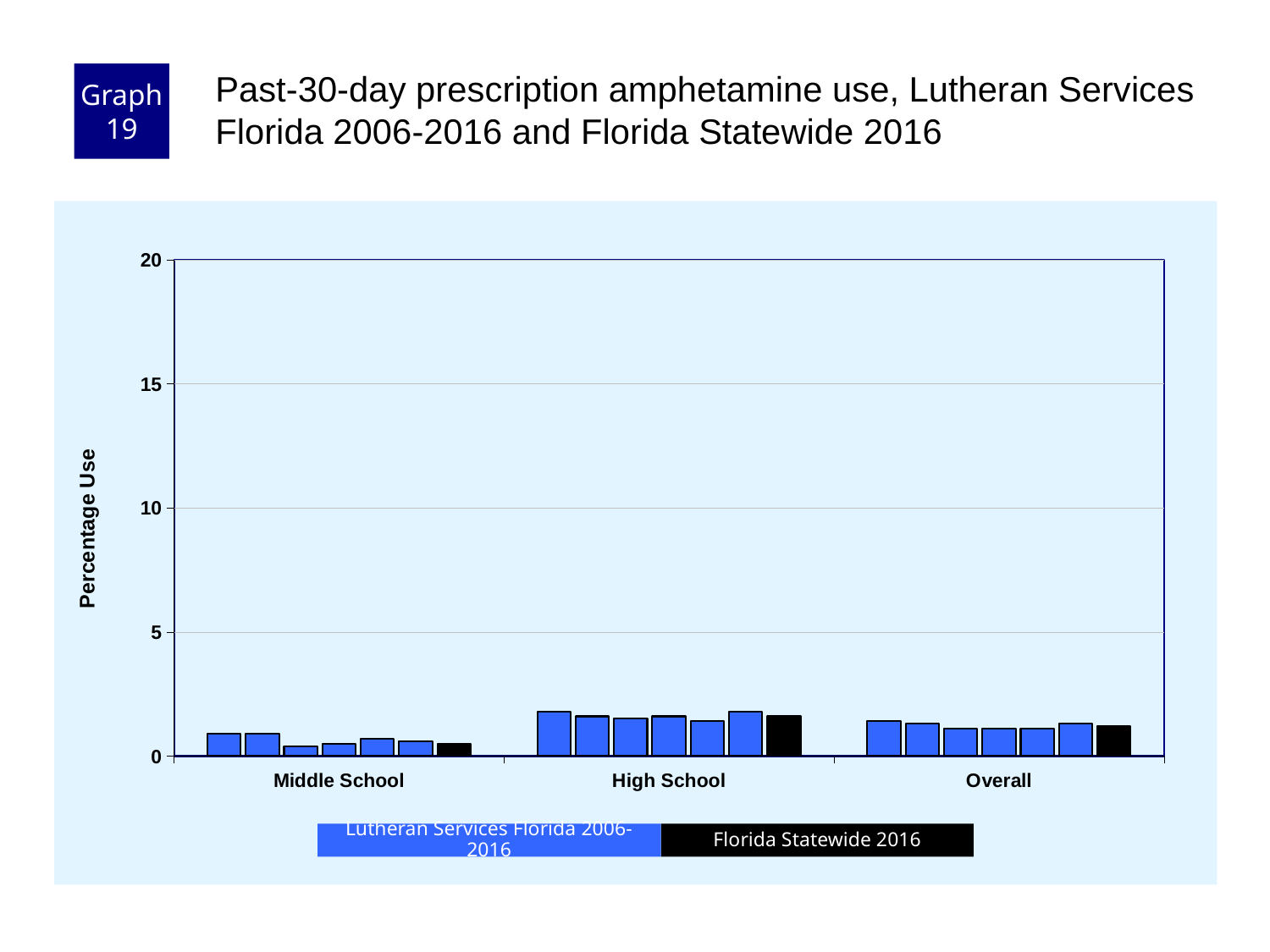
What kind of chart is shown on the slide? bar chart How many categories are shown on the x axis? 3 What colour are the Florida Statewide 2016 bars? black Is the Florida Statewide 2016 value for Middle School greater or less than 5? less Which is larger, the Florida Statewide 2016 value for High School or for Middle School? High School Which is larger, the Florida Statewide 2016 value for Overall or for Middle School? Overall Which category has the highest Florida Statewide 2016 value? High School Is the Florida Statewide 2016 value for Overall greater or less than 5? less Which category has the lowest Florida Statewide 2016 value? Middle School Is the Florida Statewide 2016 value for High School greater or less than 5? less How many series does the legend list? 2 What is the label on the y axis? Percentage Use